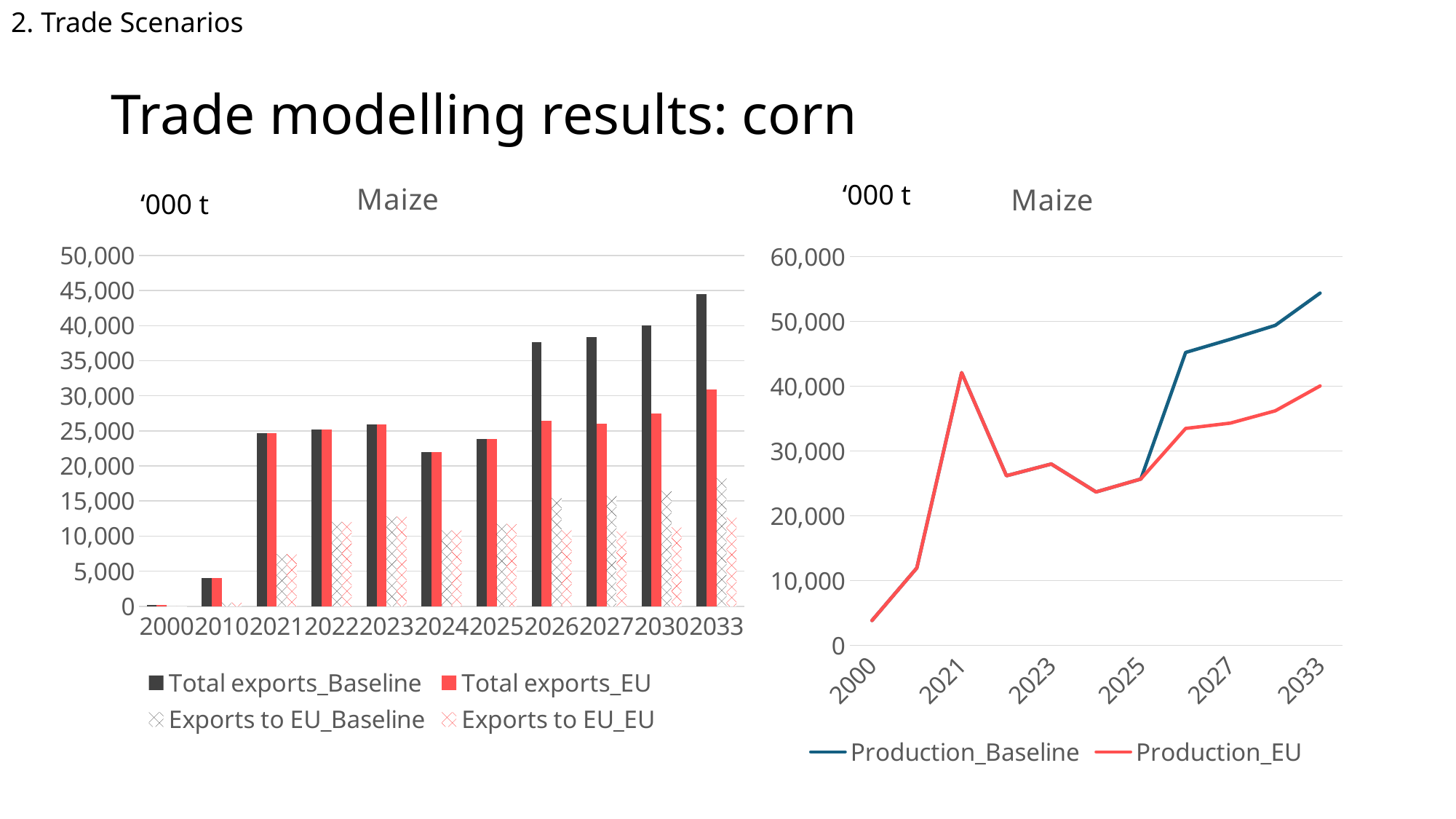
What type of chart is the left chart on the slide? bar chart What type of chart is the right chart on the slide? line chart In the left bar chart, is the Total exports_Baseline value for 2033 greater or less than 40,000? greater In the left bar chart, how many series does the legend list? 4 In the left bar chart, for 2033, which is larger: Total exports_Baseline or Total exports_EU? Total exports_Baseline In the right line chart, how many series does the legend list? 2 In the right line chart, is the Production_EU value for 2000 greater or less than 10,000? less In the right line chart, is the Production_Baseline value for 2033 greater or less than 50,000? greater In the left bar chart, how many years are shown on the x axis? 11 In the right line chart, does Production_Baseline rise or fall from 2025 to 2033? rise In the left bar chart, which year has the highest Total exports_Baseline value? 2033